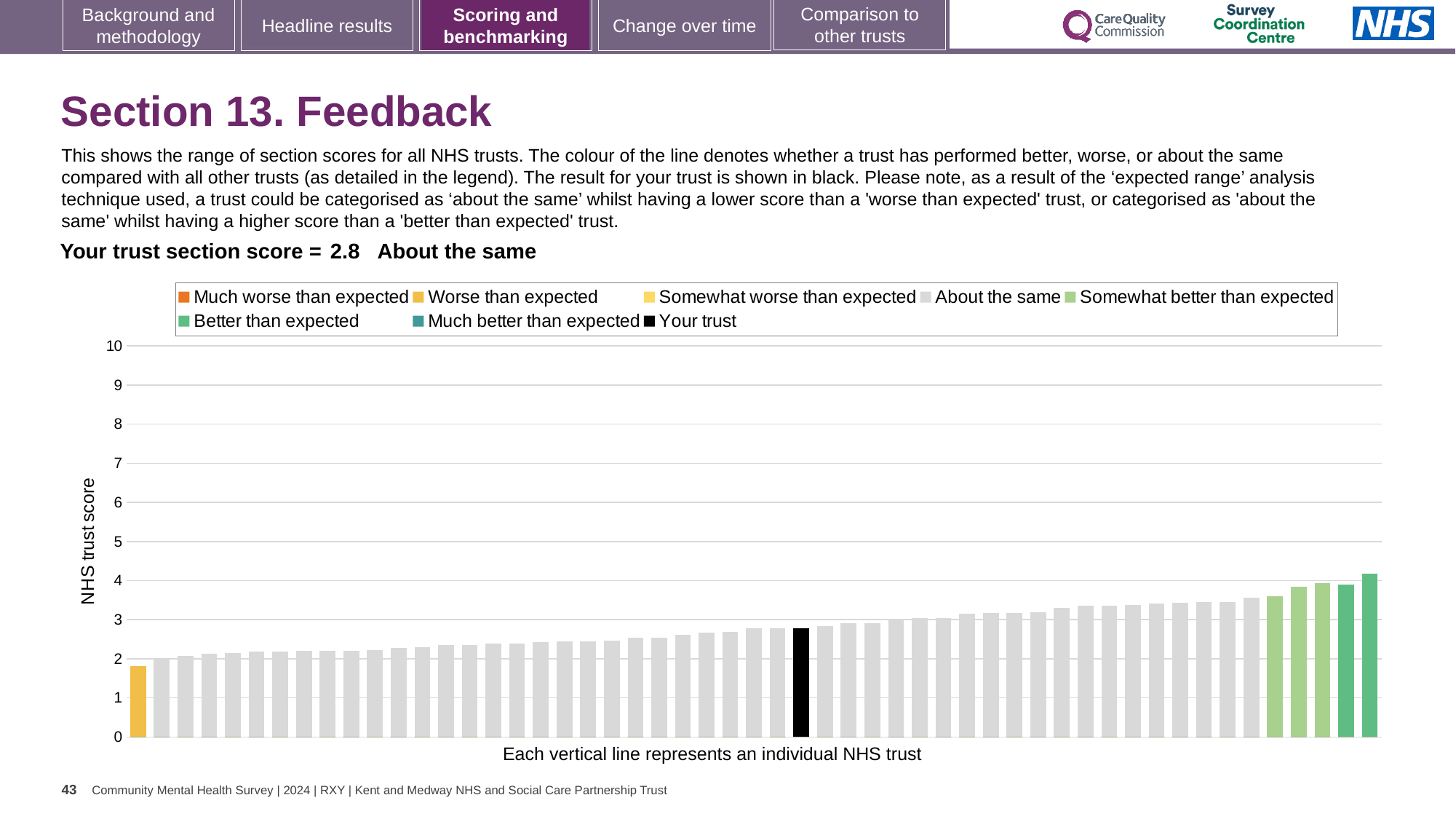
Is the value of the tallest bar greater or less than 4? greater Is the value of the black bar for your trust greater or less than 3? less What is the section score for your trust shown on the slide? 2.8 Which is higher, the black bar for your trust or the yellow bar at the far left? the black bar Is the value of the shortest bar (the yellow one at the far left) greater or less than 2? less How many entries does the chart legend list? 8 Do the bar values rise or fall from left to right along the x axis? rise How is your trust's section score categorised compared with other trusts? About the same What is the label on the vertical axis of the chart? NHS trust score What kind of chart is shown on the slide? bar chart How many bars are coloured yellow (worse than expected)? 1